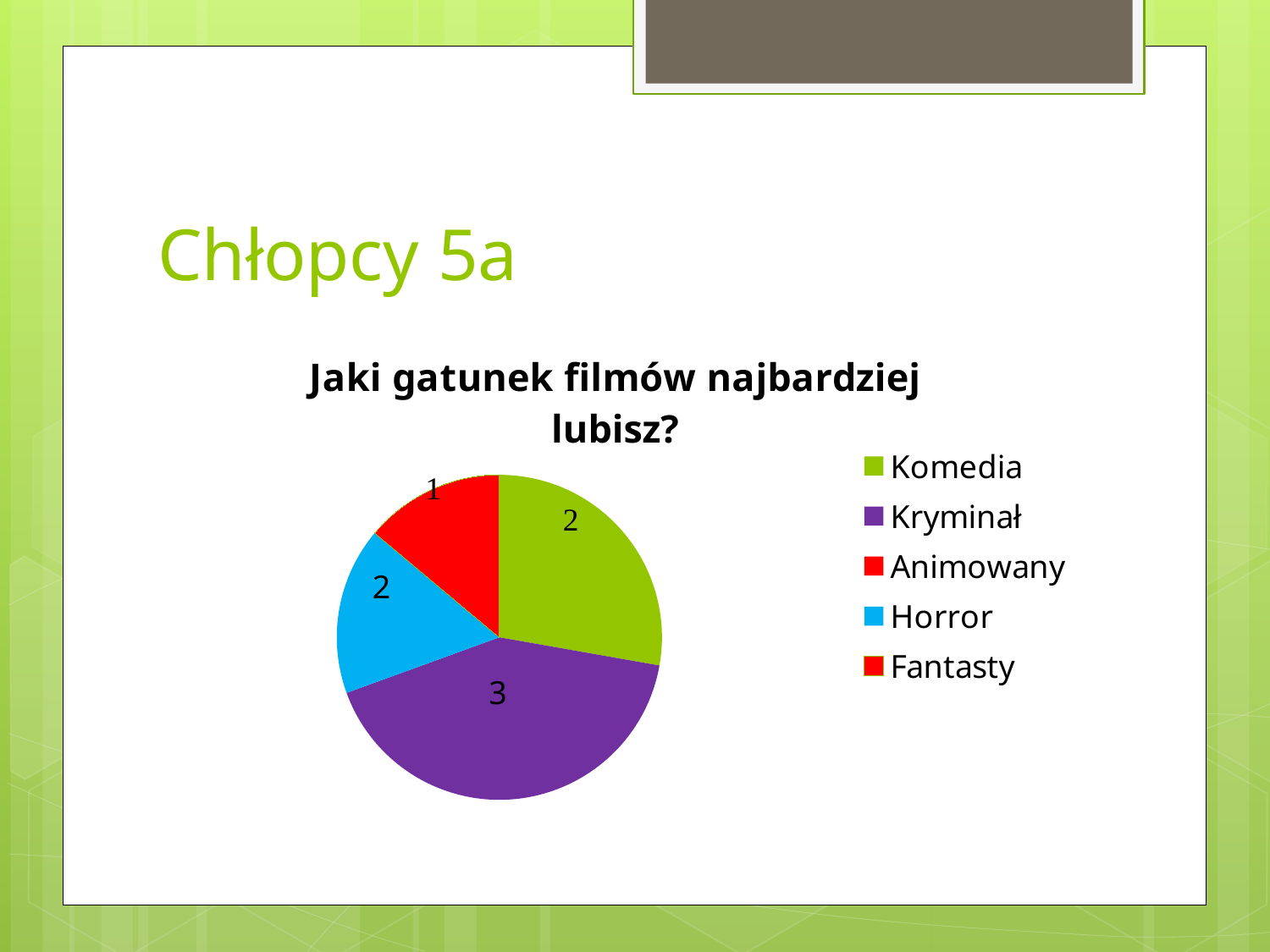
Which is larger, the value for Kryminał or the value for Komedia? Kryminał What value is shown for Kryminał? 3 What value is shown for Horror? 2 What kind of chart is shown on the slide? pie chart What colour is the Kryminał slice? purple What value is shown for Komedia? 2 What is the title of the chart? Jaki gatunek filmów najbardziej lubisz? How many categories does the legend list? 5 Which category has the largest slice of the pie? Kryminał